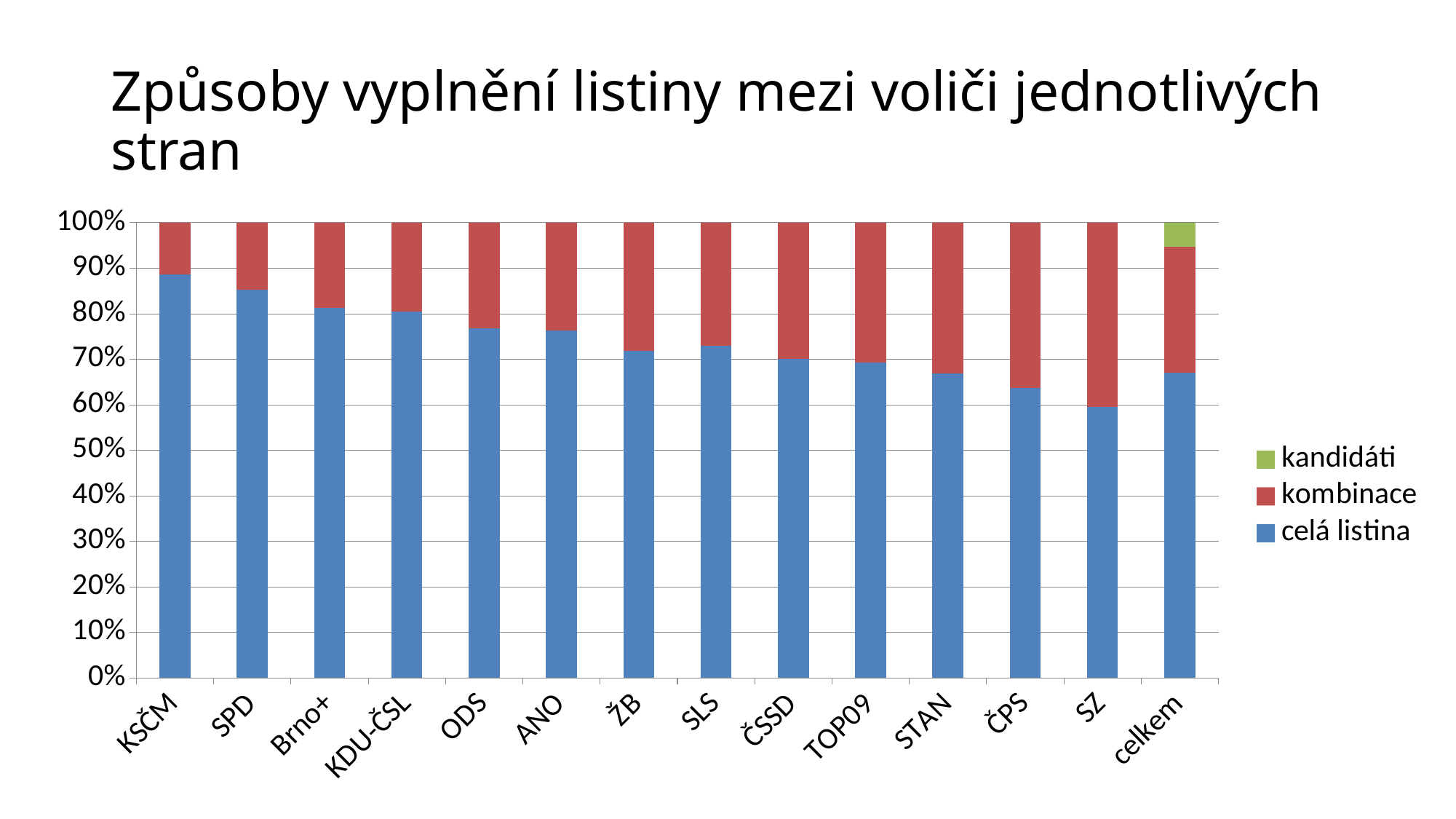
Is the 'celá listina' value for SZ greater or less than 70%? less How many categories are shown on the x axis? 14 Which category has the highest share of 'celá listina'? KSČM Is the 'celá listina' value for ODS greater or less than 70%? greater What kind of chart is shown on the slide? stacked bar chart What is the total height of each stacked bar? 100% How many series does the legend list? 3 Which category has the lowest share of 'celá listina'? SZ Is the 'celá listina' value for KSČM greater or less than 80%? greater Which has a larger 'celá listina' share, SPD or ČPS? SPD Which category is the only one with a visible 'kandidáti' segment? celkem Does the 'celá listina' share generally rise or fall from KSČM to SZ along the x axis? fall